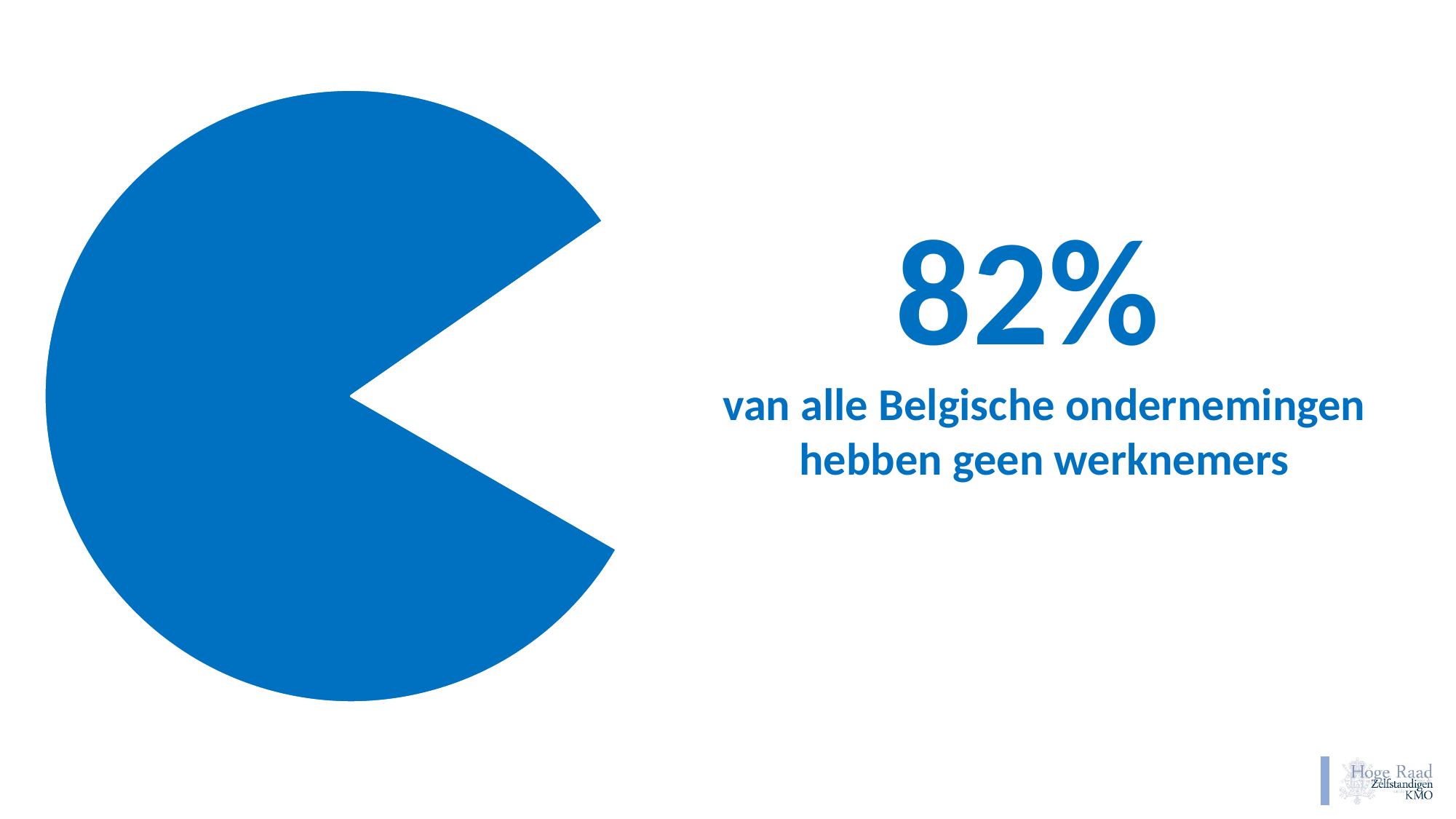
What kind of chart is shown on the slide? pie chart Is the blue slice of the pie chart greater or less than 50% of the pie? greater What share of all Belgian enterprises have no employees, according to the slide? 82% What share of the pie is not covered by the blue 82% slice? 18% Is the blue slice larger or smaller than the remaining part of the pie? larger How many slices of the pie chart are filled with colour? 1 What colour is the filled slice of the pie chart? blue What does the 82% figure on the slide represent? van alle Belgische ondernemingen hebben geen werknemers What percentage is printed next to the pie chart? 82%